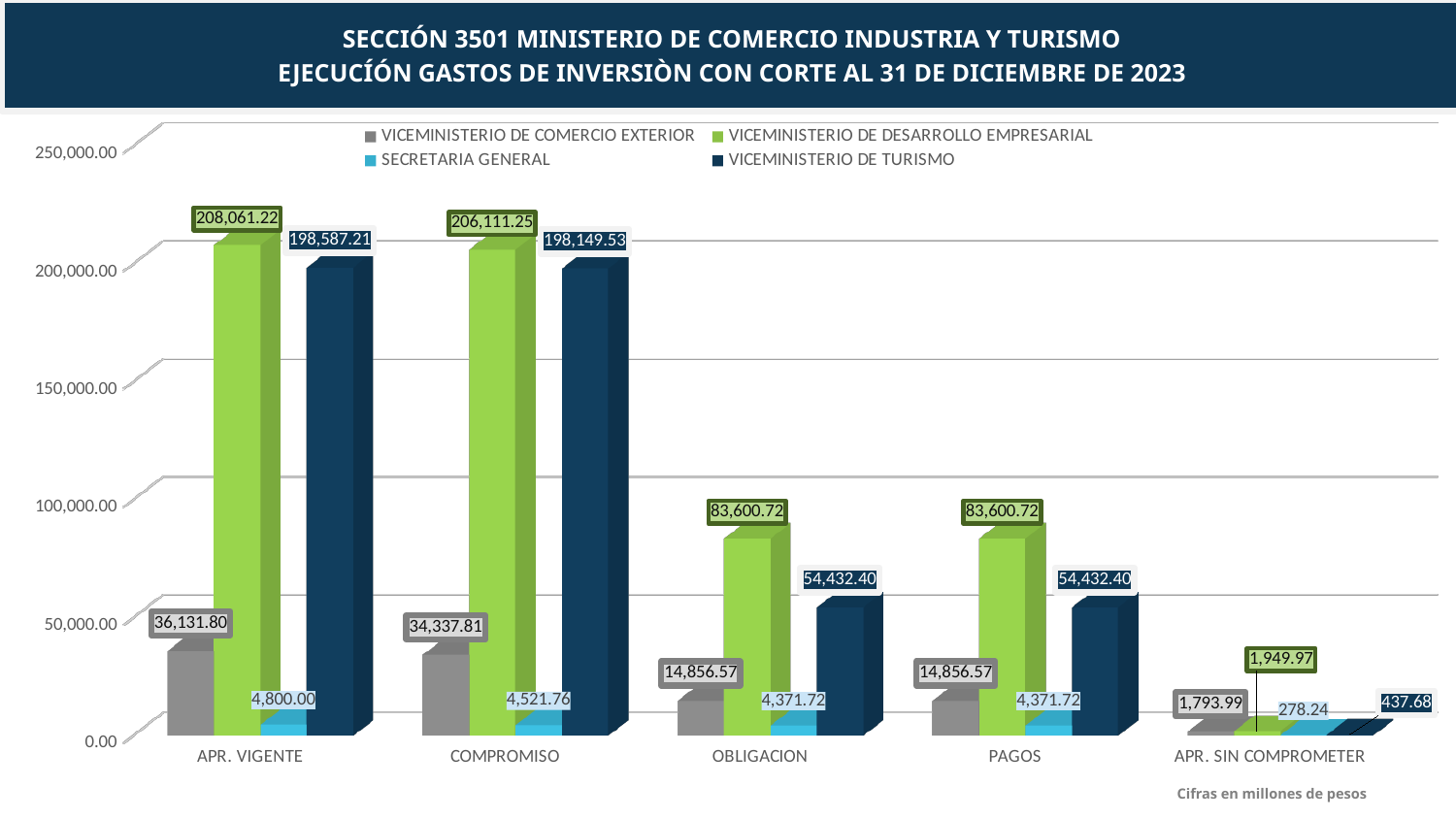
What is the difference between VICEMINISTERIO DE DESARROLLO EMPRESARIAL and VICEMINISTERIO DE TURISMO in the OBLIGACION category? 29,168.32 Which series has the lowest value in the APR. SIN COMPROMETER category? SECRETARIA GENERAL What is the value for SECRETARIA GENERAL in the OBLIGACION category? 4,371.72 What is the value for VICEMINISTERIO DE DESARROLLO EMPRESARIAL in the APR. VIGENTE category? 208,061.22 What is the value for VICEMINISTERIO DE TURISMO in the COMPROMISO category? 198,149.53 How many categories are shown on the x axis? 5 Which is larger in the COMPROMISO category: VICEMINISTERIO DE COMERCIO EXTERIOR or SECRETARIA GENERAL? VICEMINISTERIO DE COMERCIO EXTERIOR Do the values for VICEMINISTERIO DE DESARROLLO EMPRESARIAL rise or fall from APR. VIGENTE to APR. SIN COMPROMETER? Fall Which series has the highest value in the PAGOS category? VICEMINISTERIO DE DESARROLLO EMPRESARIAL What kind of chart is shown on the slide? Bar chart What is the value for VICEMINISTERIO DE COMERCIO EXTERIOR in the APR. SIN COMPROMETER category? 1,793.99 How many series does the legend list? 4